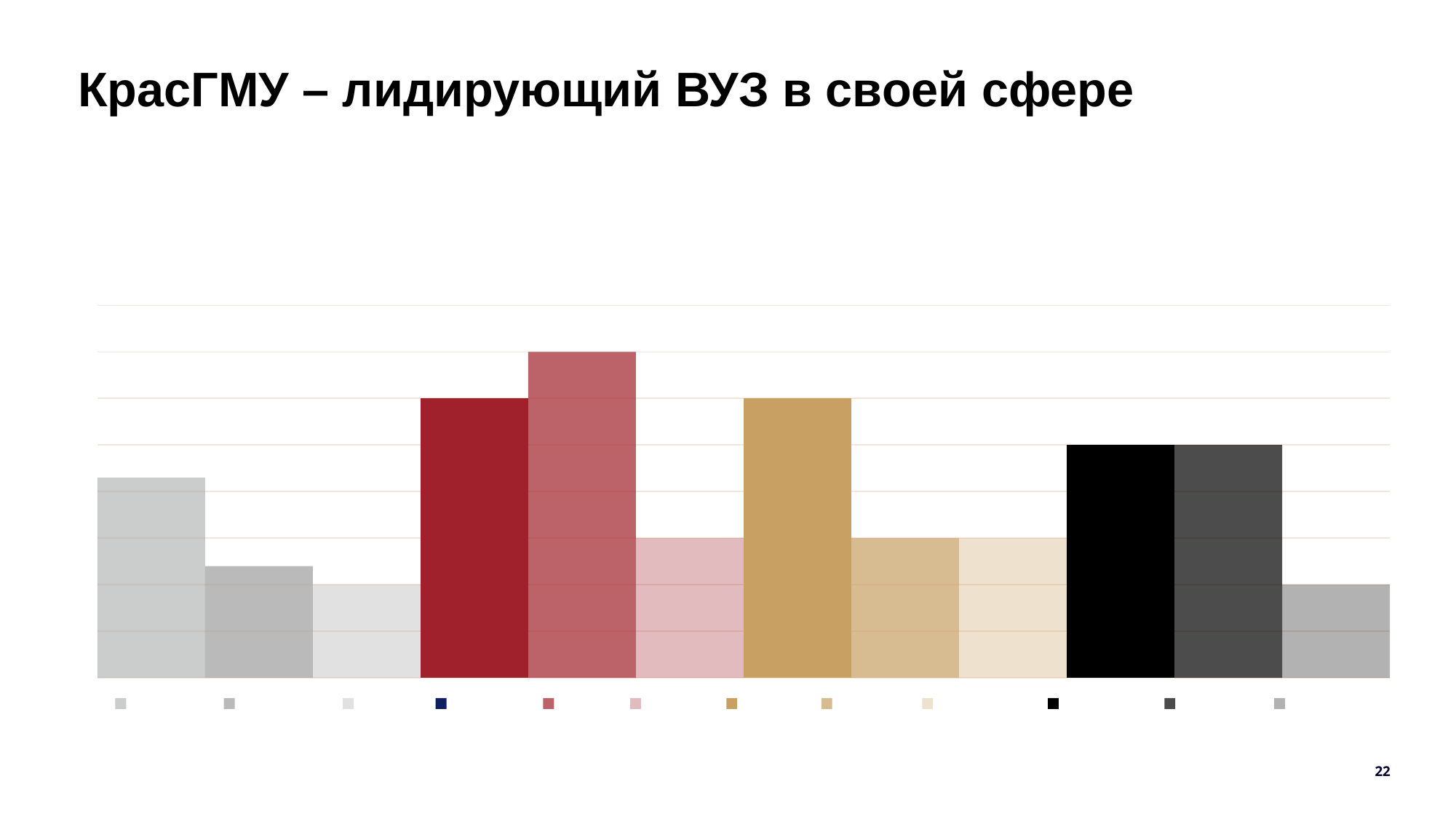
How many bars does the chart contain? 12 What is the title of the slide containing the chart? КрасГМУ – лидирующий ВУЗ в своей сфере Which is taller, the fourth bar from the left or the sixth bar from the left? the fourth bar Which bar is the tallest in the chart, counting from the left? the fifth bar What kind of chart is shown on the slide? bar chart How many entries does the legend below the chart show? 12 Which is taller, the first bar from the left or the second bar from the left? the first bar Does the chart display any numeric data labels on the bars? No Which is taller, the seventh bar from the left or the tenth bar from the left? the seventh bar